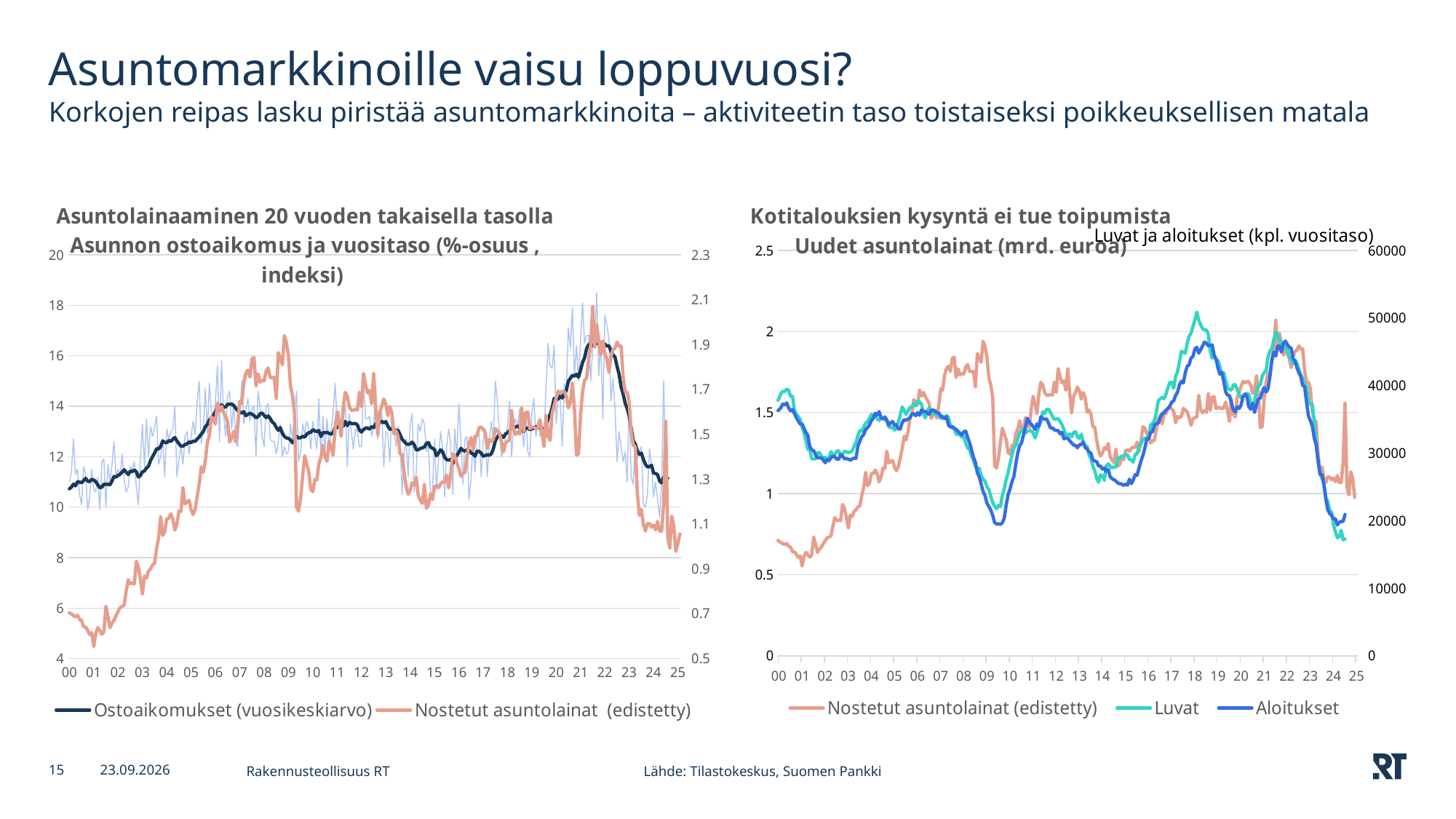
What kind of chart is the left chart titled 'Asunnon ostoaikomus ja vuositaso'? line chart In the right chart, does Luvat rise or fall from 2022 to 2024? fall In the left chart, does Ostoaikomukset (vuosikeskiarvo) rise or fall from 2022 to 2024? fall In the right chart, is the peak value of Nostetut asuntolainat (edistetty) around 2008-09 greater or less than 1.5? greater In the left chart, is the value of Nostetut asuntolainat (edistetty) in 2001 greater or less than 0.9 on the right axis? less In the right chart, is the peak value of Luvat around 2018 greater or less than 40000? greater How many series does the legend of the right chart list? 3 What kind of chart is the right chart titled 'Uudet asuntolainat (mrd. euroa)'? line chart What is the label of the secondary (right) axis of the right chart? Luvat ja aloitukset (kpl. vuositaso) How many series does the legend of the left chart list? 2